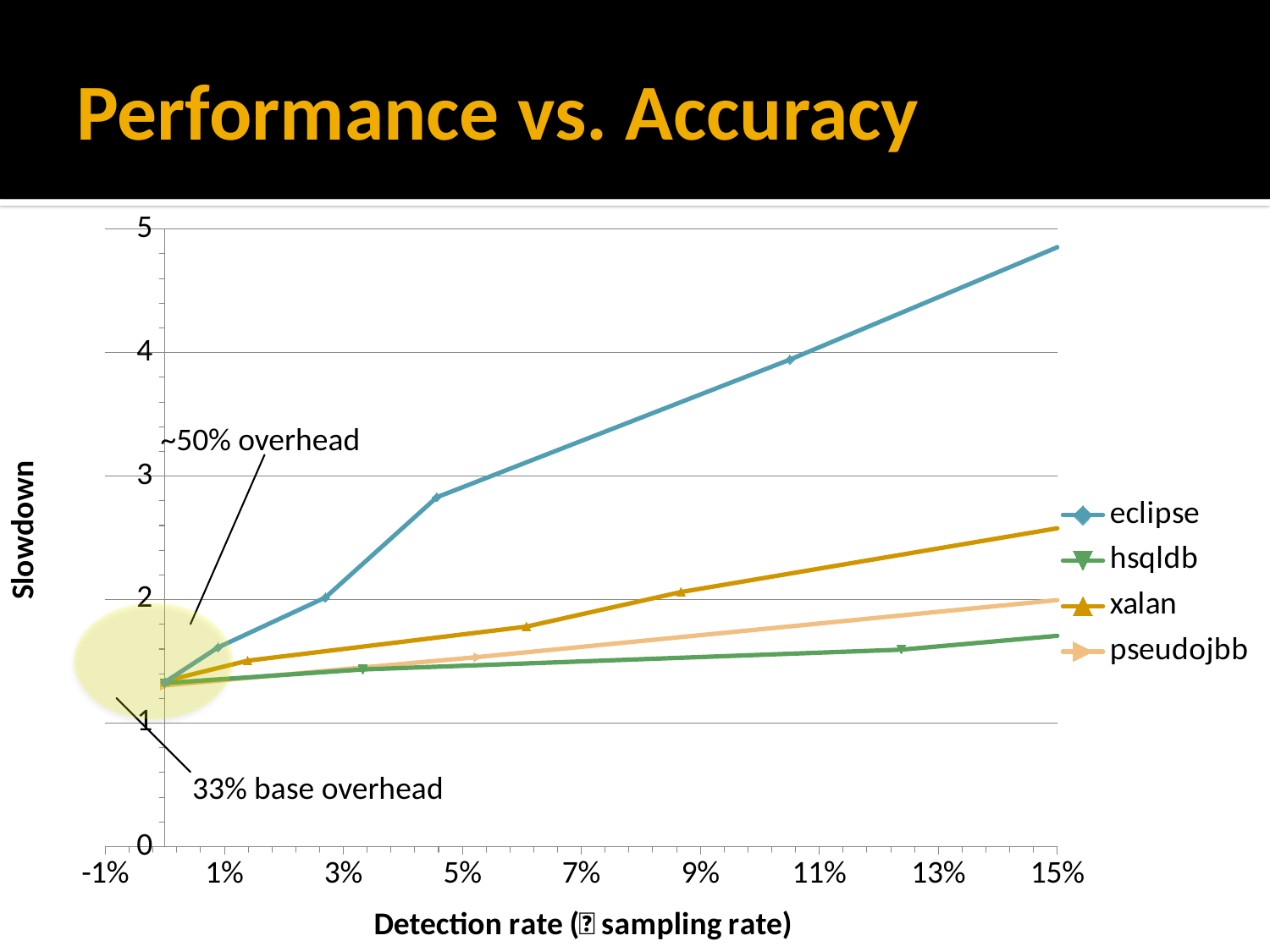
Is the slowdown for hsqldb at a 15% detection rate greater or less than 2? less Does the slowdown for eclipse rise or fall as the detection rate increases? rise Which series has the highest slowdown at a 15% detection rate? eclipse What base overhead does the annotation near the start of the lines state? 33% base overhead How many series does the legend list? 4 Is the slowdown for eclipse at roughly an 11% detection rate greater or less than 3? greater At a 15% detection rate, which series has the larger slowdown, xalan or pseudojbb? xalan Is the slowdown for xalan at a 15% detection rate greater or less than 2? greater What kind of chart is shown on the slide? line chart What is the label of the y axis? Slowdown Which series has the lowest slowdown at a 15% detection rate? hsqldb